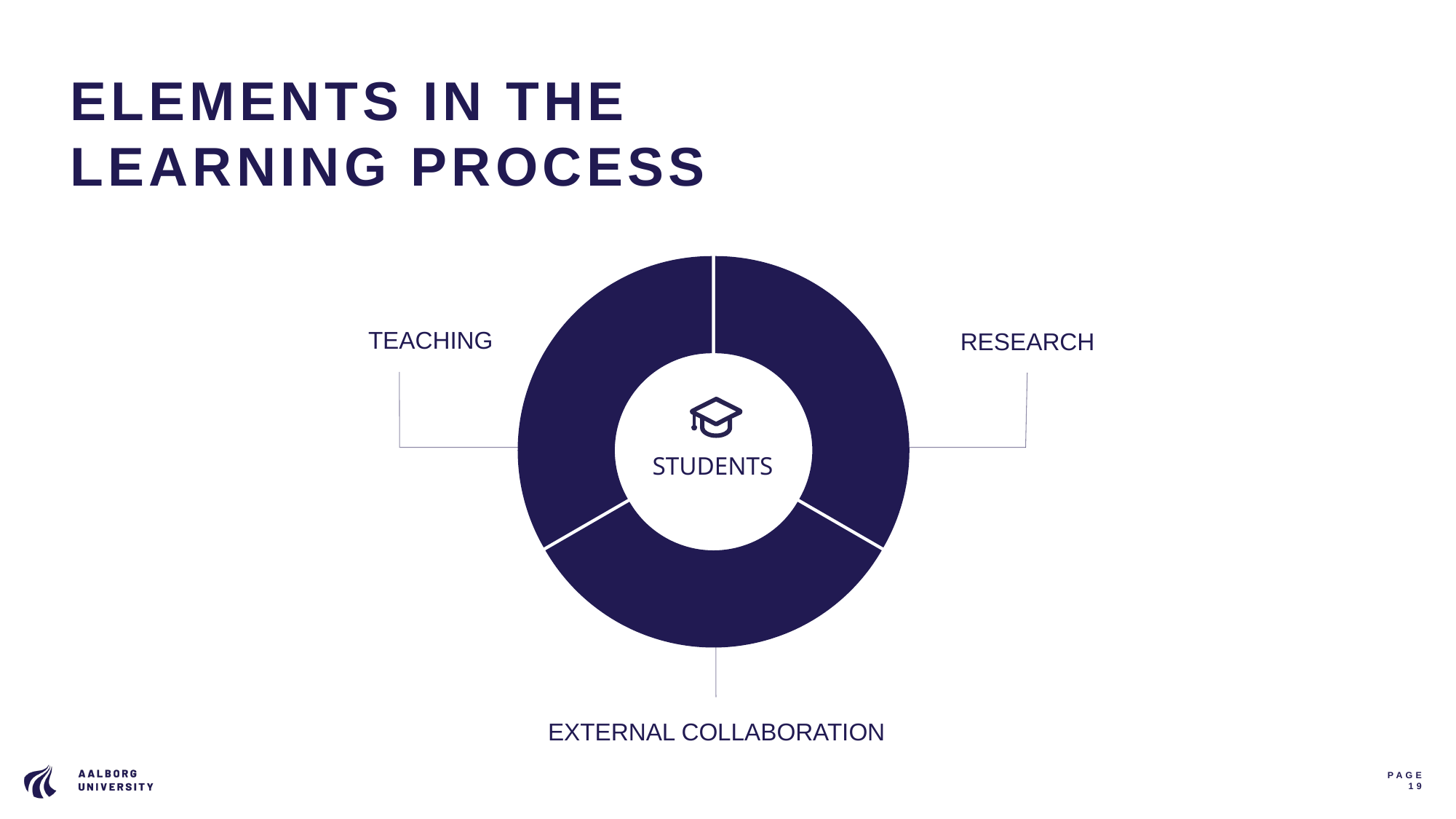
Which segment of the doughnut chart is labelled at the bottom of the slide? External collaboration What label appears in the centre of the doughnut chart? Students What kind of chart is shown on the slide? Doughnut chart Which segment of the doughnut chart is labelled on the left side? Teaching What is the title of the slide containing the doughnut chart? Elements in the learning process Are any numeric data labels printed on the doughnut chart segments? No How many segments does the doughnut chart have? 3 Which segment of the doughnut chart is labelled on the right side? Research